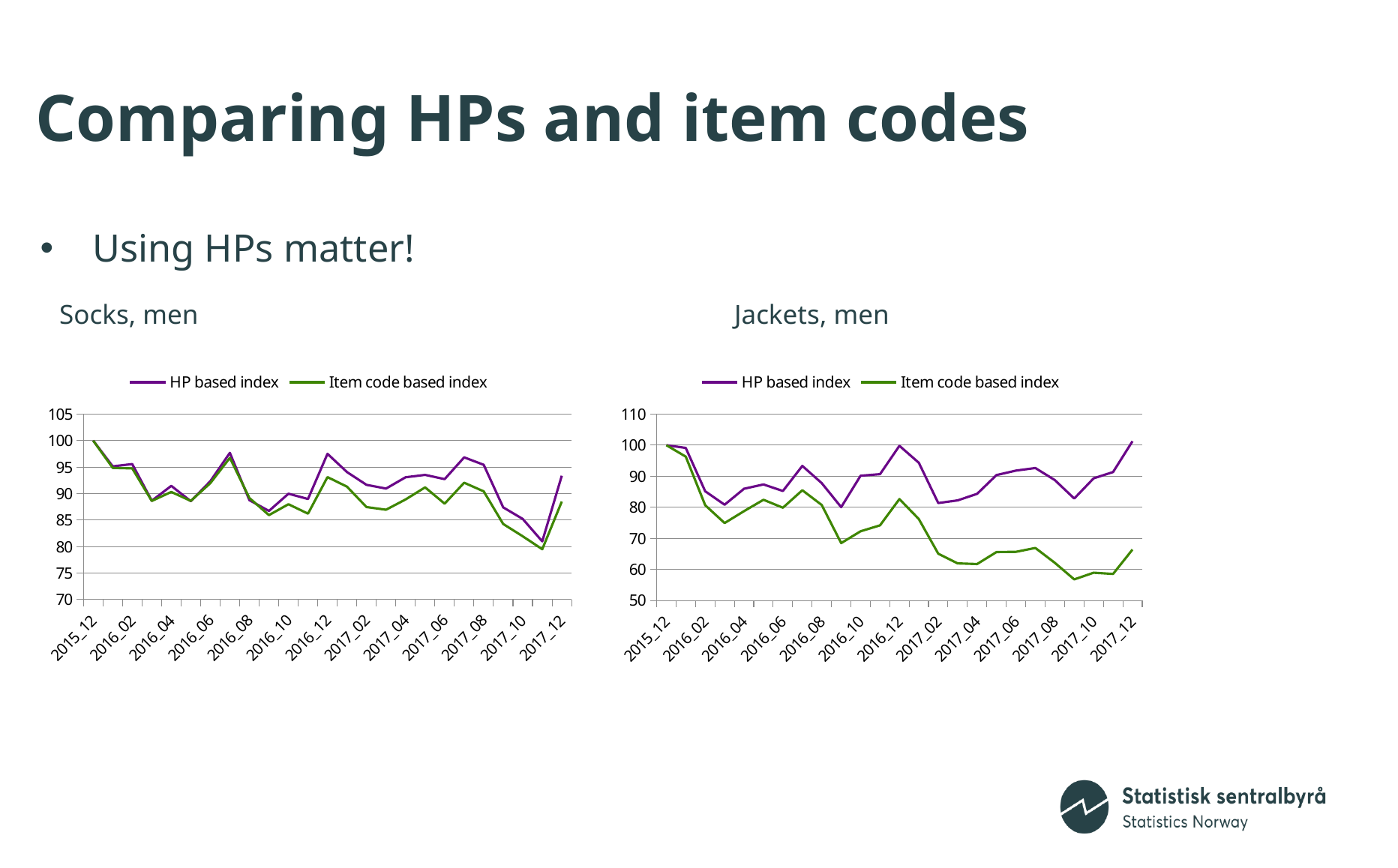
In the "Socks, men" chart, what is the value of the HP based index at 2015_12? 100 In the "Jackets, men" chart, which series has the larger value at 2017_12, the HP based index or the Item code based index? HP based index What colour is the HP based index line in the "Jackets, men" chart? purple In the "Jackets, men" chart, what is the value of the Item code based index at 2015_12? 100 In the "Socks, men" chart, which series has the larger value at 2017_12, the HP based index or the Item code based index? HP based index How many series does the legend of the "Jackets, men" chart list? 2 In the "Jackets, men" chart, does the Item code based index overall rise or fall from 2015_12 to 2017_12? fall In the "Socks, men" chart, is the Item code based index at 2017_02 greater or less than 90? less In the "Socks, men" chart, is the HP based index at 2016_12 greater or less than 95? greater What kind of chart is the "Socks, men" chart? line chart What are the two legend entries in the "Socks, men" chart? HP based index; Item code based index